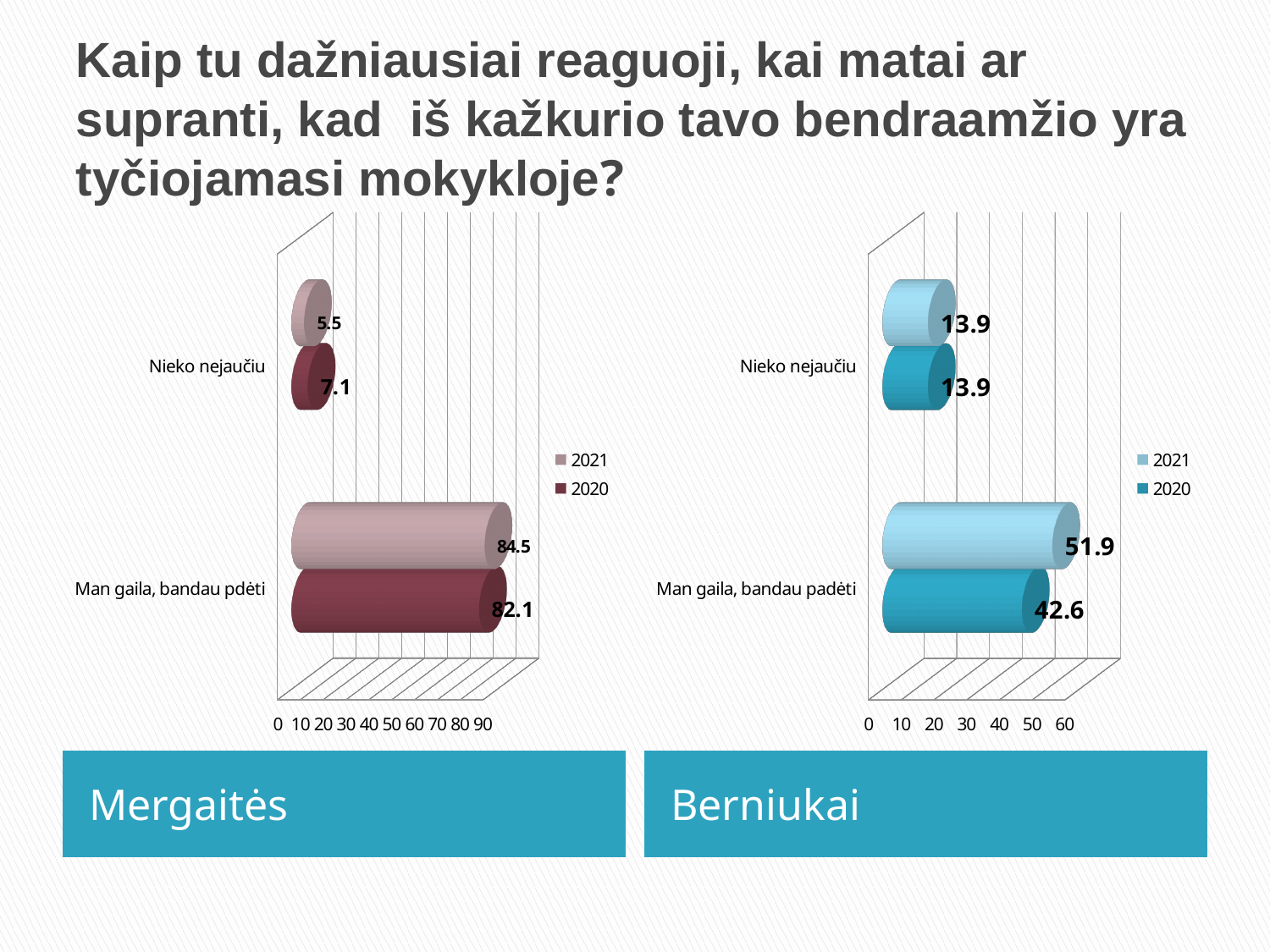
In the left chart (Mergaitės), which category has the highest 2021 value? Man gaila, bandau pdėti How many categories are shown in the right chart (Berniukai)? 2 In the right chart (Berniukai), what is the 2020 value for "Man gaila, bandau padėti"? 42.6 In the left chart (Mergaitės), is the 2020 value for "Nieko nejaučiu" larger or smaller than the 2021 value? larger How many series does the legend of the right chart (Berniukai) list? 2 In the right chart (Berniukai), what is the difference between the 2021 and 2020 values for "Man gaila, bandau padėti"? 9.3 In the right chart (Berniukai), which category has the lowest 2020 value? Nieko nejaučiu In the left chart (Mergaitės), what is the 2021 value for "Man gaila, bandau pdėti"? 84.5 In the left chart (Mergaitės), what is the difference between the 2021 and 2020 values for "Man gaila, bandau pdėti"? 2.4 In the left chart (Mergaitės), what is the 2020 value for "Nieko nejaučiu"? 7.1 What kind of chart is the left chart (Mergaitės)? bar chart In the right chart (Berniukai), what is the 2021 value for "Nieko nejaučiu"? 13.9